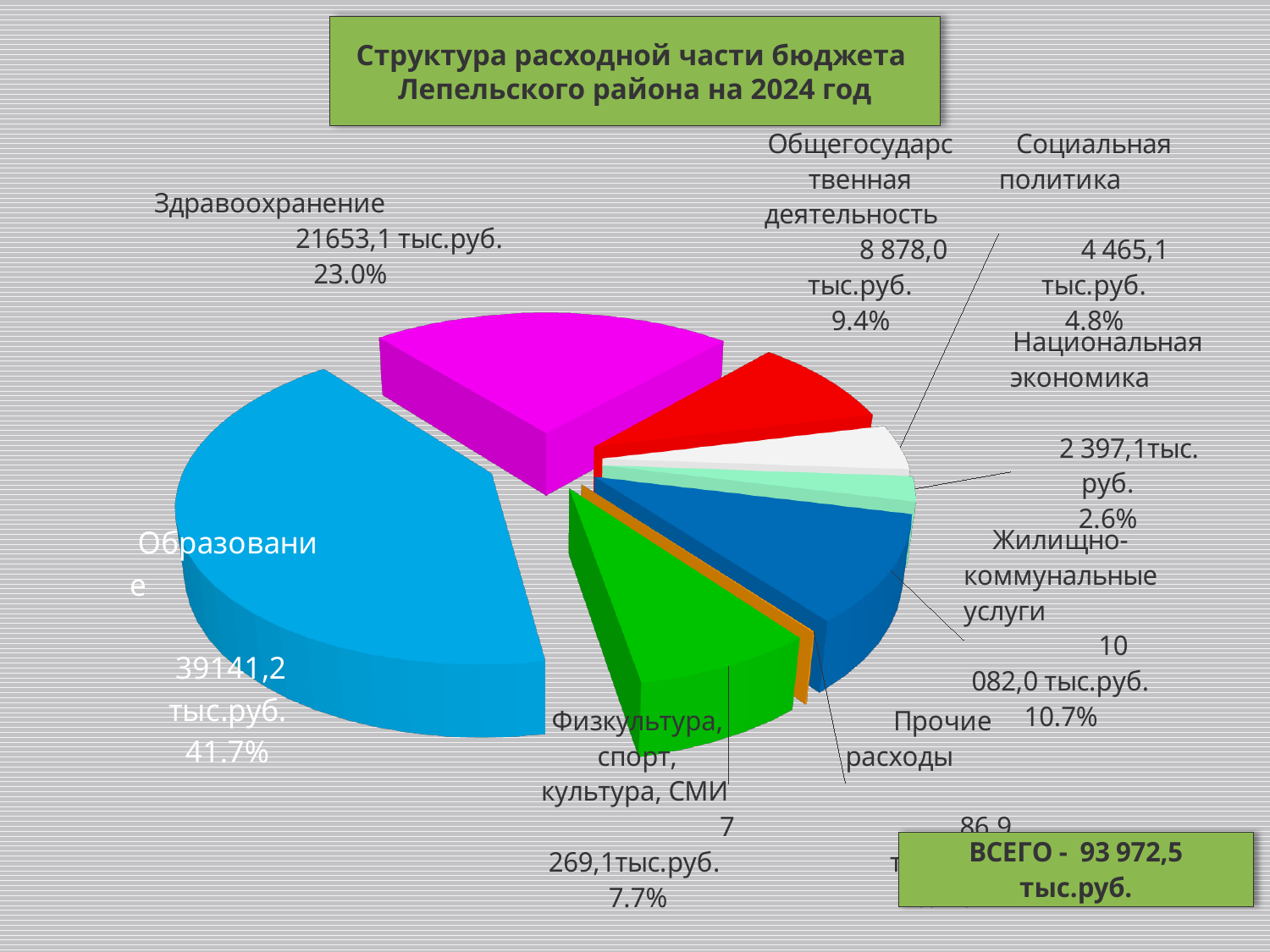
What total (ВСЕГО) is shown on the slide? 93 972,5 тыс.руб. What share of the pie does Жилищно-коммунальные услуги take? 10.7% What is the difference in percentage share between Образование and Здравоохранение? 18.7% What is the value for Общегосударственная деятельность? 8 878,0 тыс.руб. What kind of chart is shown on the slide? pie chart What is the value for Образование? 39141,2 тыс.руб. Which category has the largest share of the pie? Образование What share of the pie does Национальная экономика take? 2.6% What share of the pie does Здравоохранение take? 23.0% Which is larger, Здравоохранение or Жилищно-коммунальные услуги? Здравоохранение What is the value for Физкультура, спорт, культура, СМИ? 7 269,1тыс.руб. What is the value for Социальная политика? 4 465,1 тыс.руб.